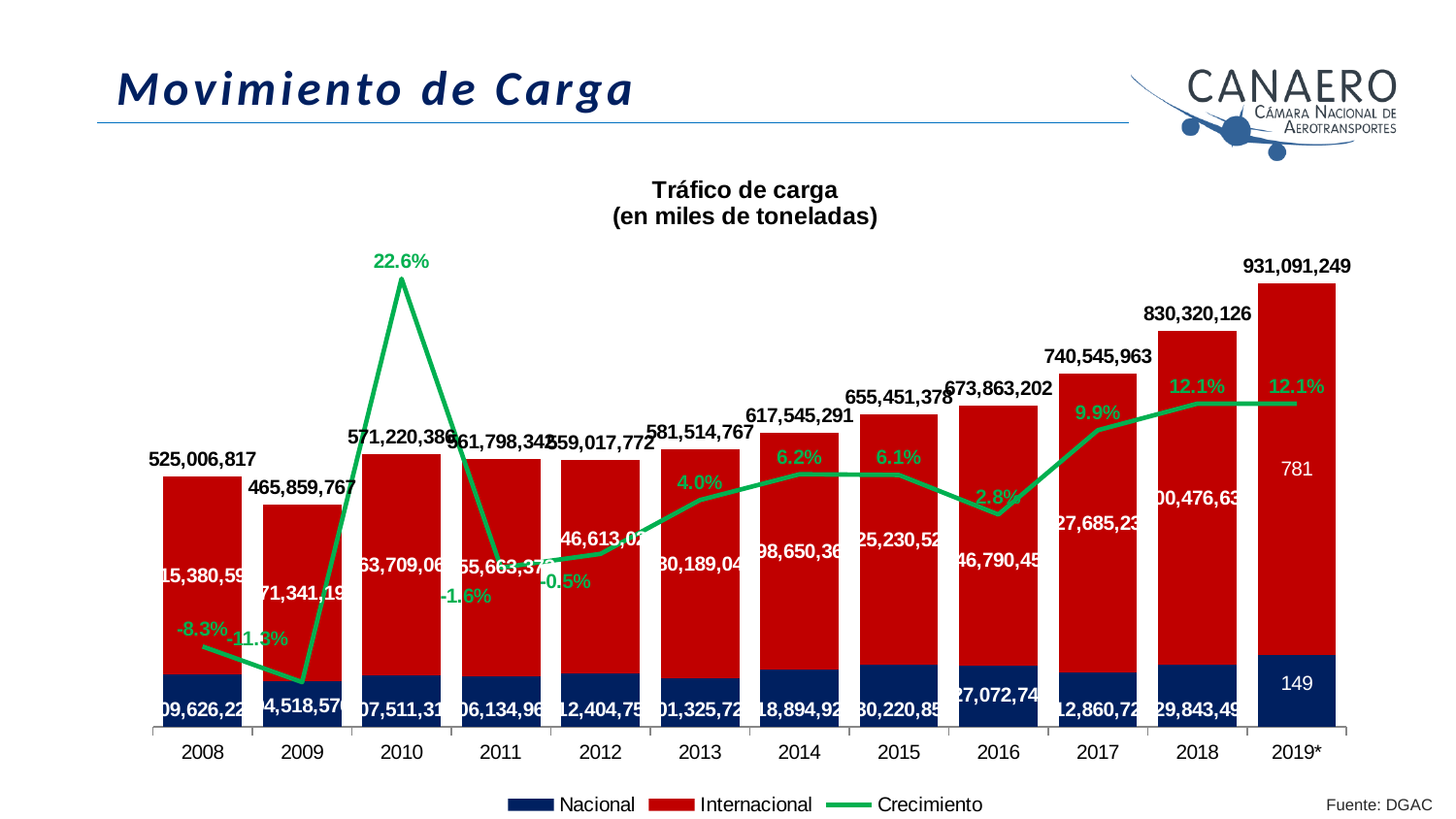
What type of chart is used to show the Nacional and Internacional series? Stacked bar chart Which year has the highest total cargo traffic? 2019* How many years are shown on the x axis? 12 How many series does the legend list? 3 Which year has the lowest total cargo traffic? 2009 Which is larger, the total cargo traffic in 2014 or in 2015? 2015 What is the Crecimiento value for 2009? -11.3% What is the Crecimiento value for 2010? 22.6% What is the title of the chart? Tráfico de carga (en miles de toneladas) What is the total cargo traffic value labelled for 2019*? 931,091,249 What is the total cargo traffic value labelled for 2008? 525,006,817 What is the difference between the total cargo traffic in 2018 and 2017? 89,774,163